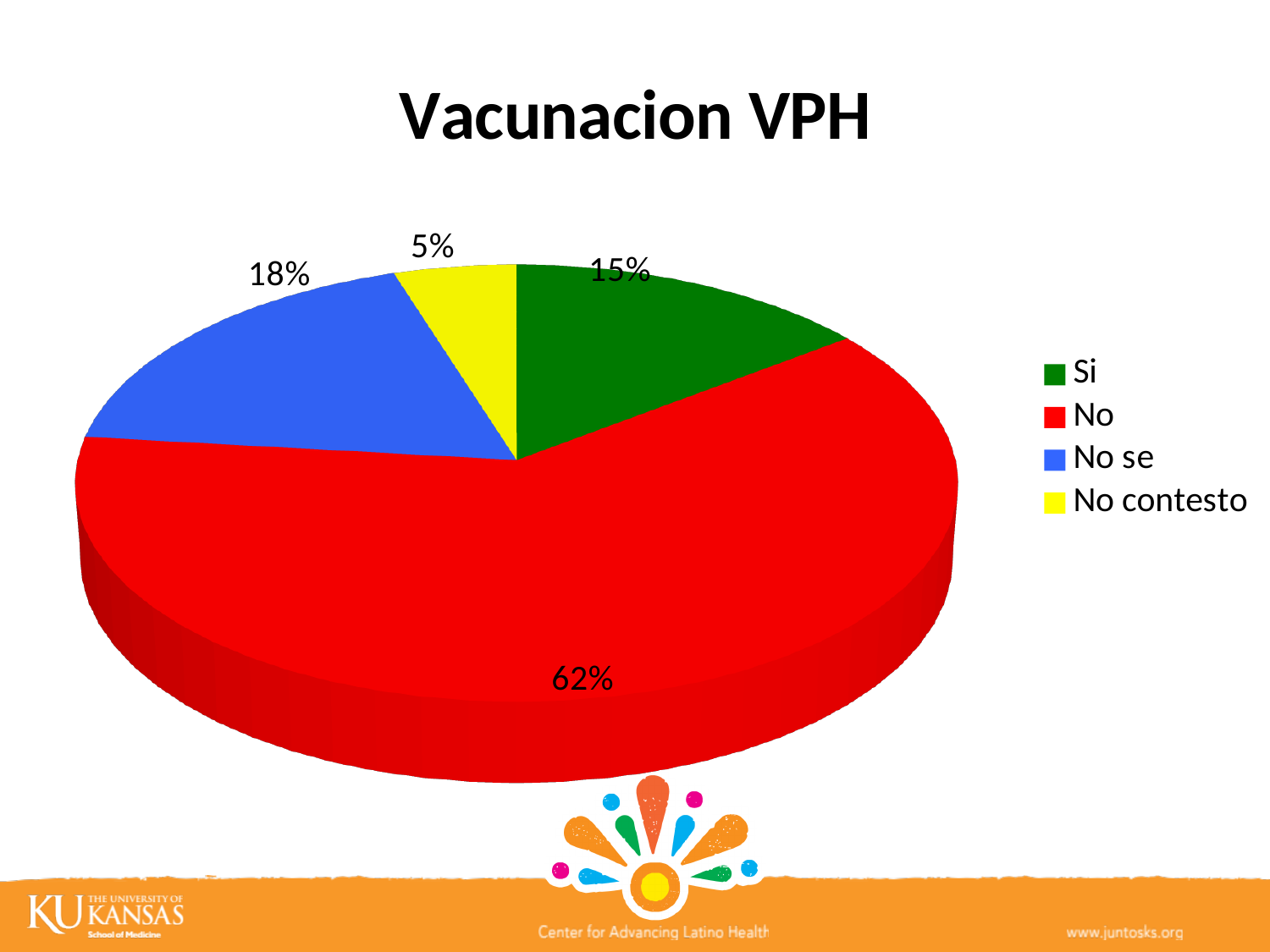
Which category has the smallest slice of the pie? No contesto What kind of chart is shown on the slide? pie chart What colour is the 'No se' slice? blue What percentage of the pie is the 'No contesto' slice? 5% What percentage of the pie is the 'No se' slice? 18% How many categories does the legend list? 4 Which category has the largest slice of the pie? No What percentage of the pie is the 'No' slice? 62% What percentage of the pie is the 'Si' slice? 15% What is the title of the chart? Vacunacion VPH Which slice is larger, 'No se' or 'Si'? No se What is the difference in percentage points between the 'No' slice and the 'Si' slice? 47